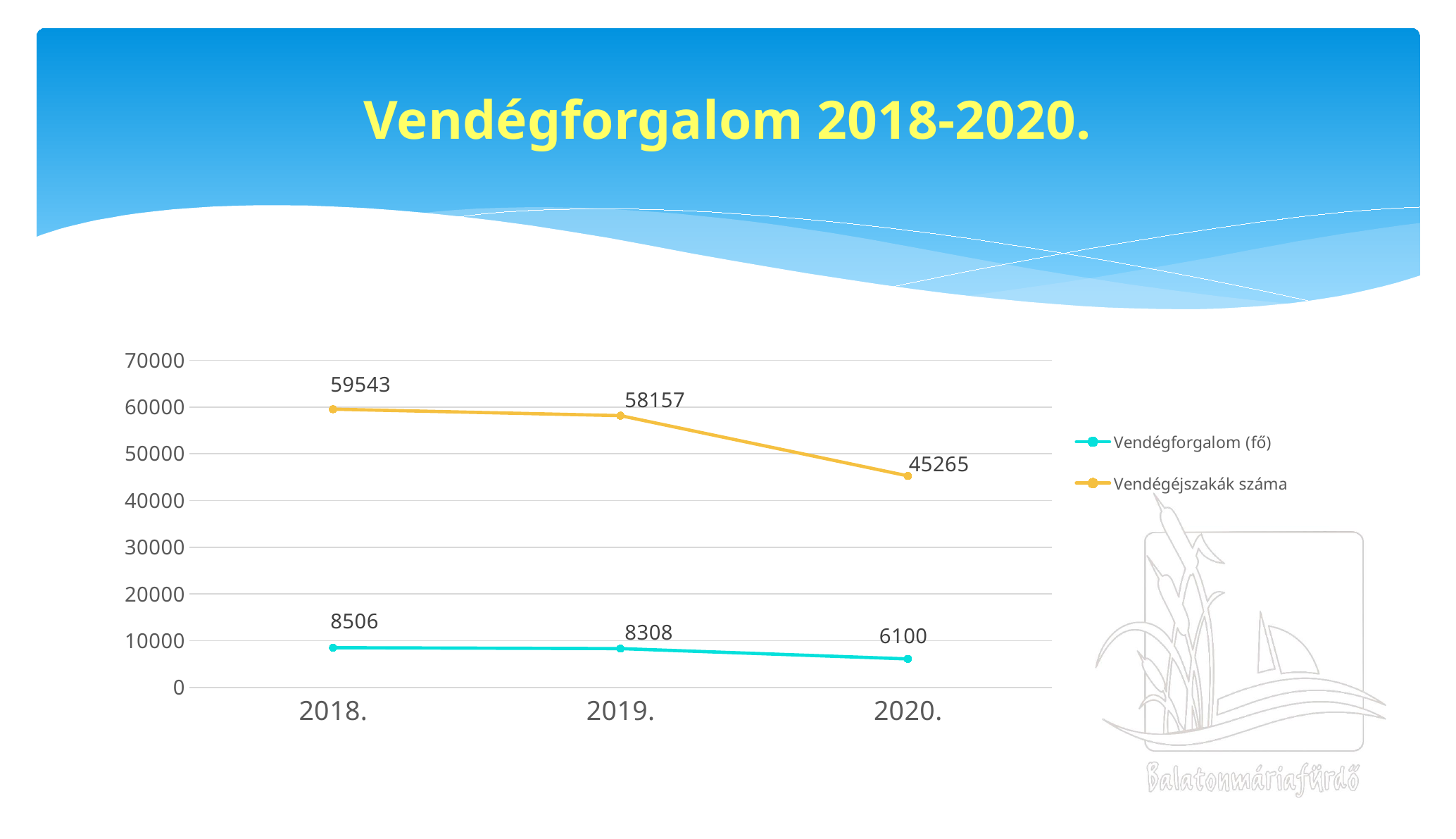
What is the value of Vendégforgalom (fő) for 2020.? 6100 How many years are shown on the x axis? 3 In which year is Vendégforgalom (fő) highest? 2018. What is the difference between Vendégéjszakák száma in 2019. and 2020.? 12892 What is the difference between Vendégforgalom (fő) in 2018. and 2019.? 198 What is the value of Vendégéjszakák száma for 2020.? 45265 Is the value of Vendégéjszakák száma for 2020. greater or less than 50000? less What kind of chart is shown on the slide? line chart In which year is Vendégéjszakák száma lowest? 2020. What is the value of Vendégéjszakák száma for 2018.? 59543 How many series does the legend list? 2 Which is larger: Vendégéjszakák száma in 2018. or in 2019.? 2018.